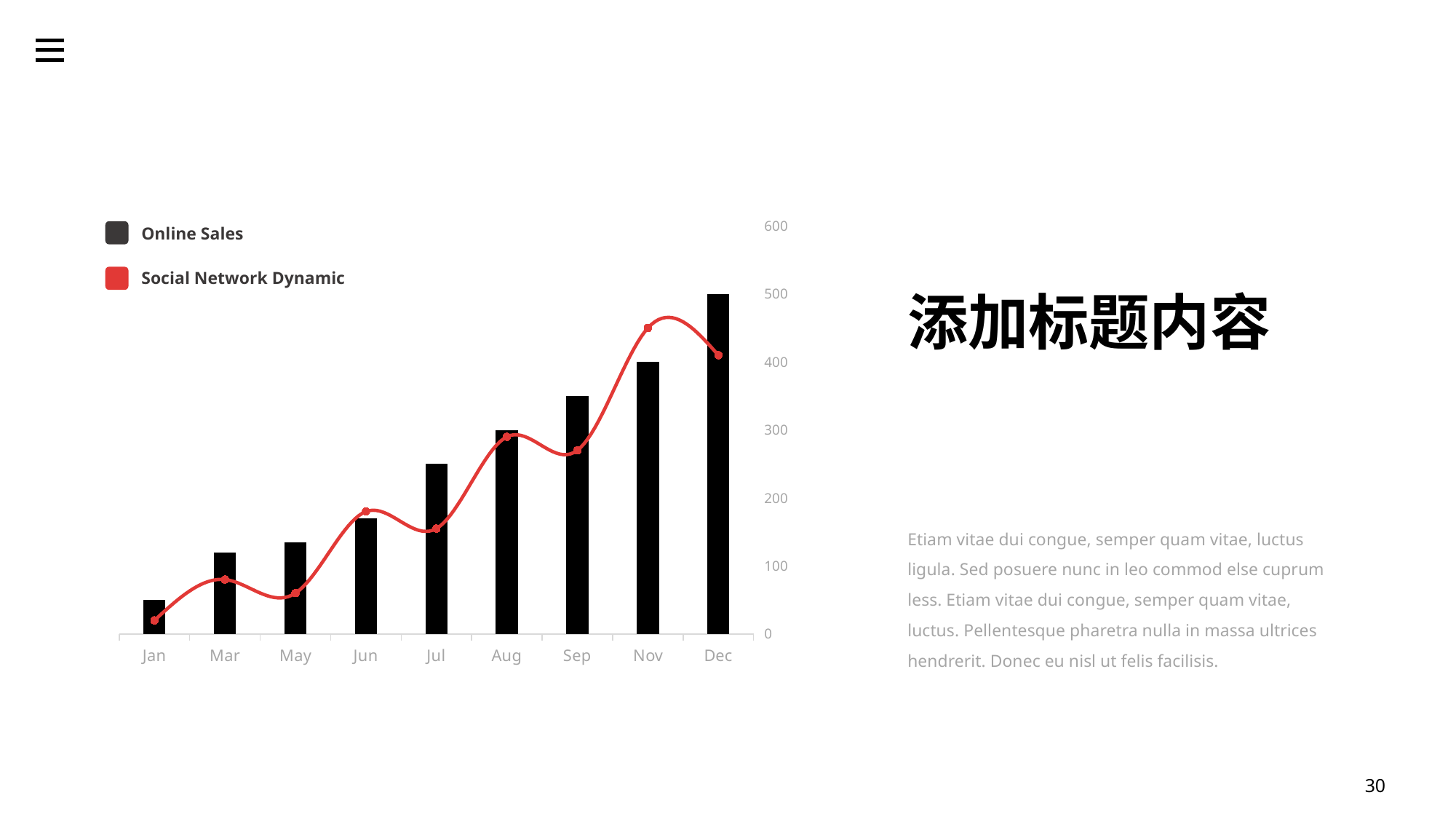
How many months are shown on the x axis of the chart? 9 What colour represents Social Network Dynamic in the legend? Red In which month is the Social Network Dynamic line at its lowest point? Jan Is the Social Network Dynamic value for Nov greater or less than 400? greater Which month has the lowest Online Sales bar? Jan In which month does the Social Network Dynamic line reach its highest point? Nov How many series does the chart's legend list? 2 In Dec, which is larger: Online Sales or Social Network Dynamic? Online Sales What kind of chart is shown on the slide? A bar chart combined with a line chart Is the Online Sales value for Jul greater or less than 200? greater Do the Online Sales bars generally rise or fall from Jan to Dec? Rise Which month has the highest Online Sales bar? Dec